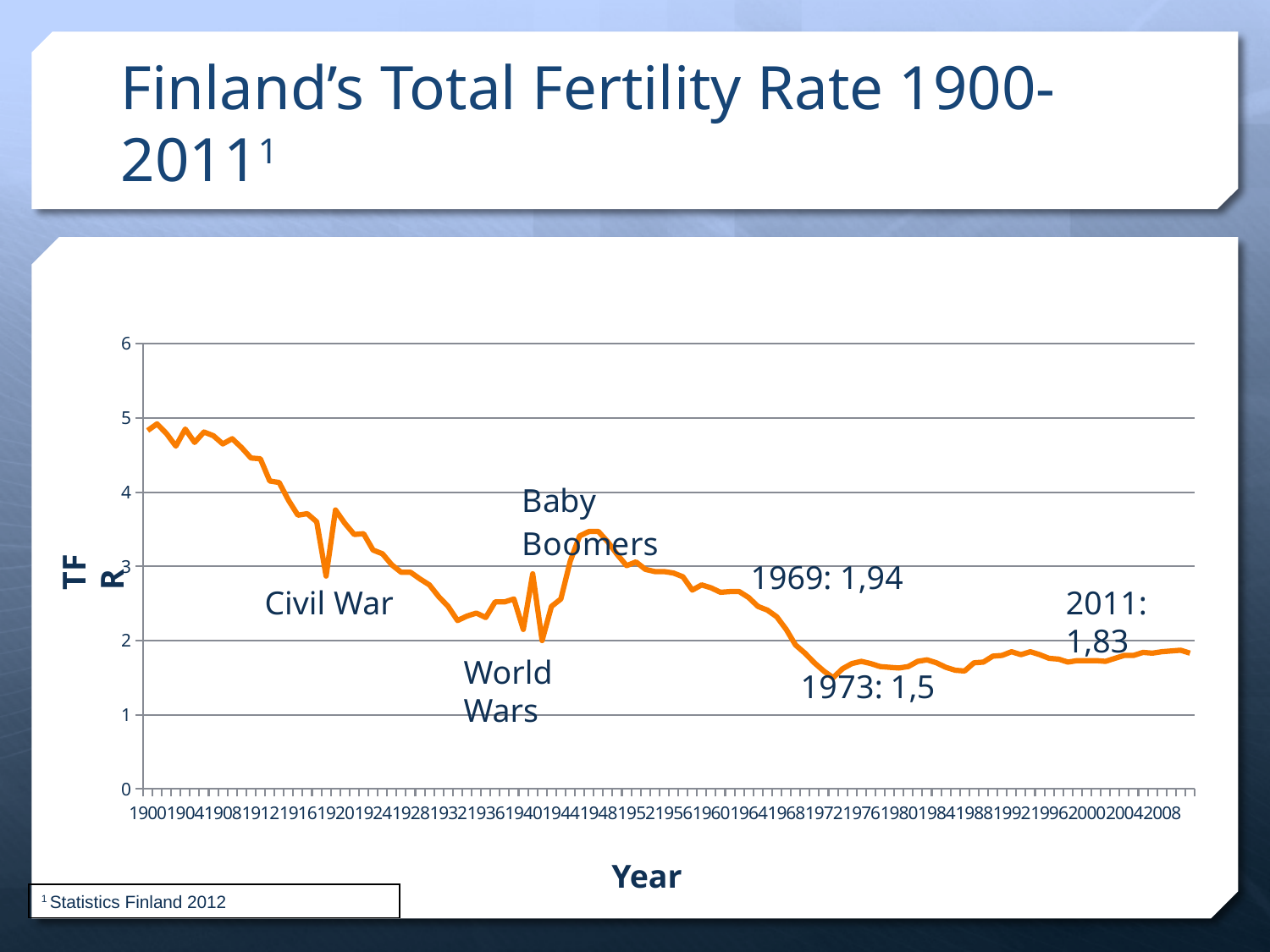
Which year had the higher total fertility rate, 1969 or 2011? 1969 Overall, does the total fertility rate rise or fall from 1900 to 2011? fall What is the title of the x axis? Year Is the total fertility rate in 1980 greater or less than 2? less What was Finland's total fertility rate in 1973 according to the chart annotation? 1,5 By how much did the total fertility rate fall between 1969 and 1973? 0,44 What kind of chart is shown on the slide? Line chart What was Finland's total fertility rate in 2011 according to the chart annotation? 1,83 What is the difference between the total fertility rate in 2011 and in 1973? 0,33 Which historical event is labelled on the chart near the dip around 1918? Civil War Is the total fertility rate in 1900 greater or less than 4? greater What was Finland's total fertility rate in 1969 according to the chart annotation? 1,94